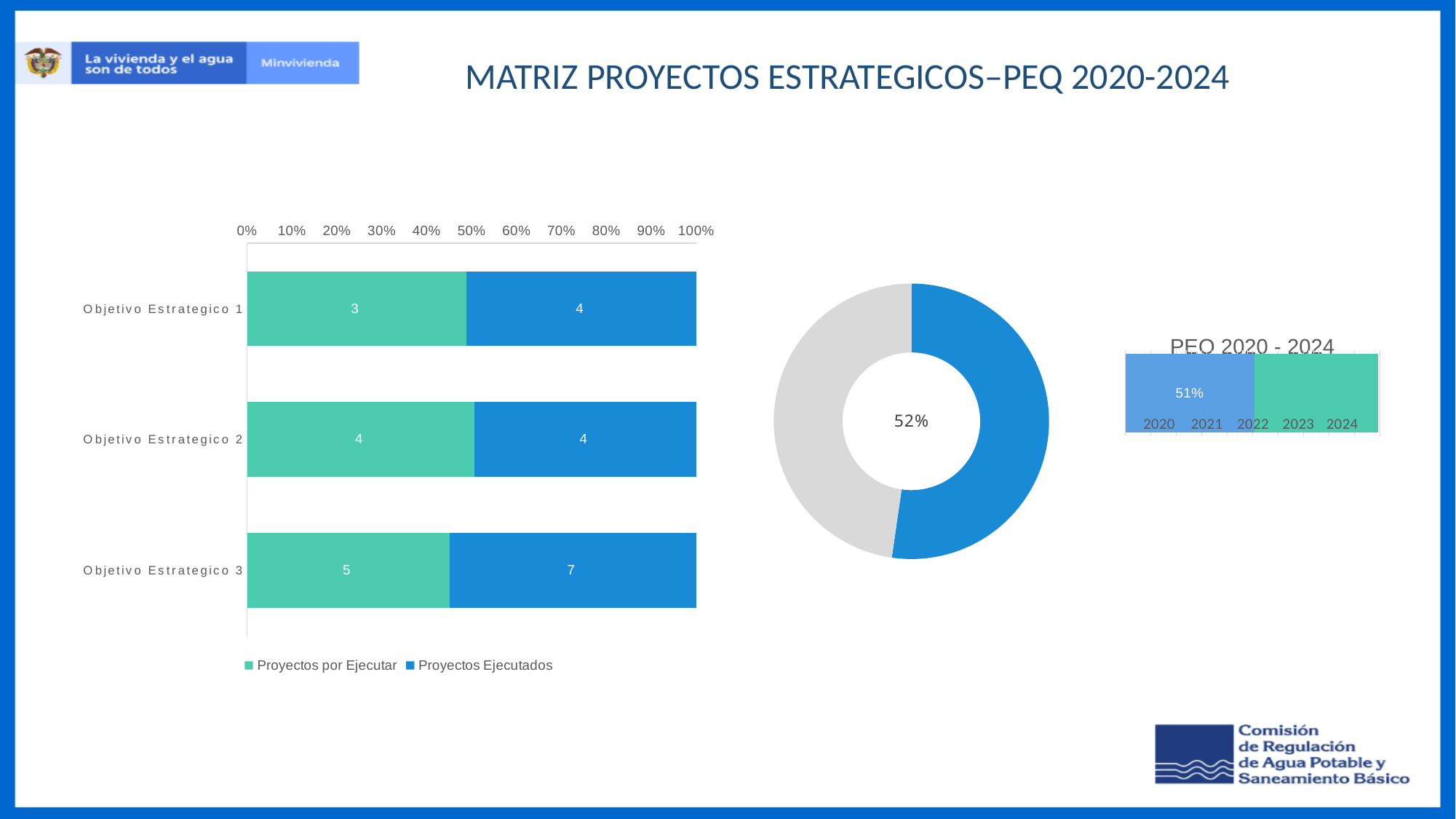
In the stacked bar chart on the left, what is the difference between Proyectos Ejecutados and Proyectos por Ejecutar for Objetivo Estrategico 3? 2 In the stacked bar chart on the left, what is the total of the two segments for Objetivo Estrategico 1? 7 How many categories (objectives) are shown in the stacked bar chart on the left? 3 In the stacked bar chart on the left, how many Proyectos Ejecutados are shown for Objetivo Estrategico 3? 7 In the stacked bar chart on the left, which objective has the highest number of Proyectos Ejecutados? Objetivo Estrategico 3 What percentage is shown in the centre of the donut chart in the middle of the slide? 52% How many series does the legend of the stacked bar chart on the left list? 2 In the stacked bar chart on the left, for Objetivo Estrategico 3, which is larger: Proyectos por Ejecutar or Proyectos Ejecutados? Proyectos Ejecutados In the stacked bar chart on the left, which objective has the lowest number of Proyectos por Ejecutar? Objetivo Estrategico 1 In the stacked bar chart on the left, what is the total of the two segments for Objetivo Estrategico 3? 12 In the stacked bar chart on the left, how many Proyectos por Ejecutar are shown for Objetivo Estrategico 1? 3 In the small chart titled 'PEQ 2020 - 2024' on the right, what percentage is printed on the blue bar? 51%